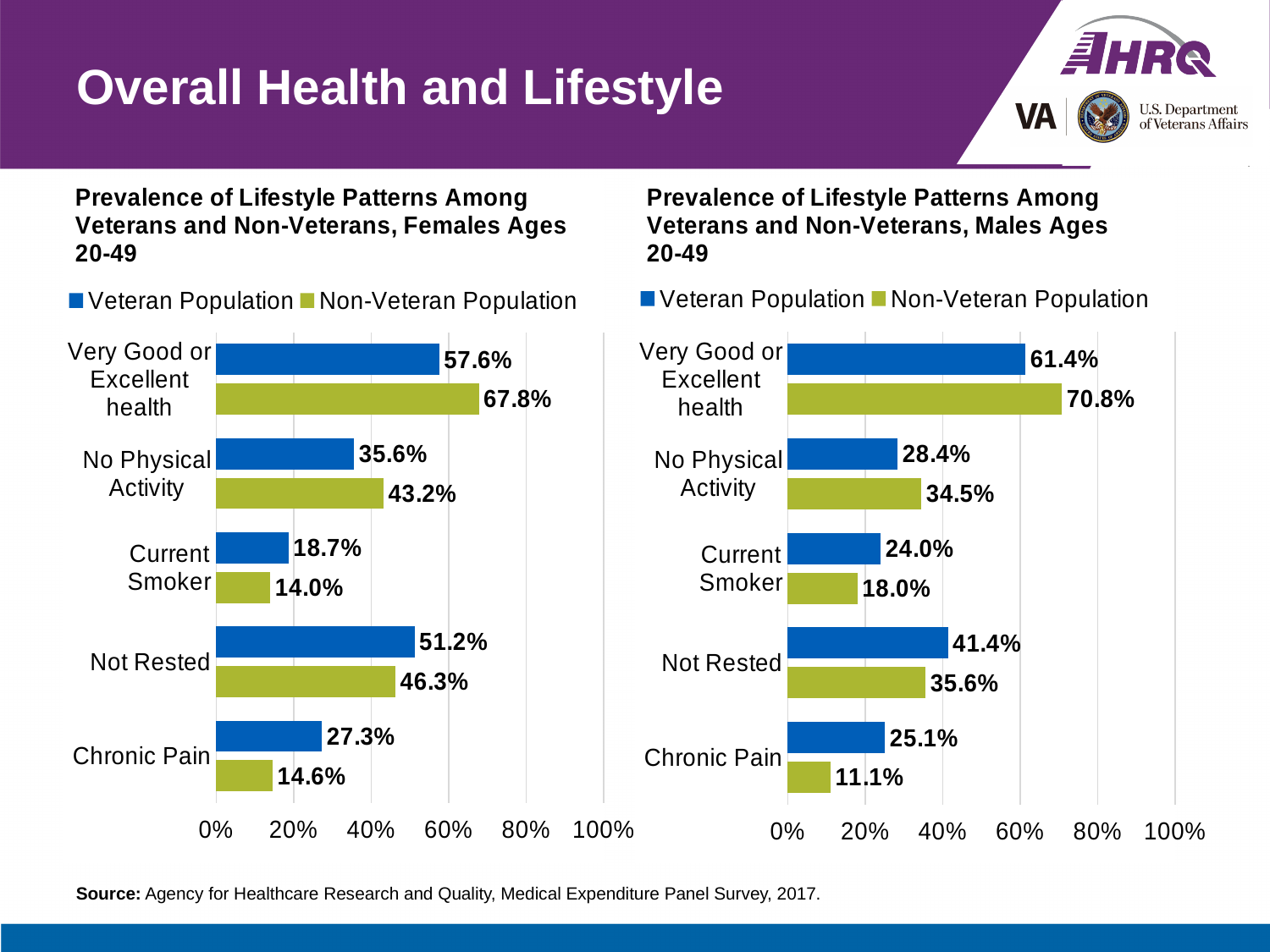
In the Males Ages 20-49 chart, is the Non-Veteran Population value for Very Good or Excellent health greater or less than 60%? greater In the Males Ages 20-49 chart, what is the value for the Non-Veteran Population for Chronic Pain? 11.1% How many series does the legend of the Males Ages 20-49 chart list? 2 In the Males Ages 20-49 chart, what is the difference between the Veteran and Non-Veteran Population values for Not Rested? 5.8% In the Females Ages 20-49 chart, what is the difference between the Non-Veteran and Veteran Population values for Very Good or Excellent health? 10.2% In the Females Ages 20-49 chart, what is the value for the Veteran Population for Very Good or Excellent health? 57.6% In the Females Ages 20-49 chart, which category has the highest Non-Veteran Population value? Very Good or Excellent health How many categories are shown in the Females Ages 20-49 chart? 5 What type of chart is the Females Ages 20-49 chart? Bar chart In the Males Ages 20-49 chart, which colour represents the Non-Veteran Population? Green In the Males Ages 20-49 chart, which category has the lowest Veteran Population value? Current Smoker In the Females Ages 20-49 chart, which is larger for Current Smoker: the Veteran Population or the Non-Veteran Population? Veteran Population